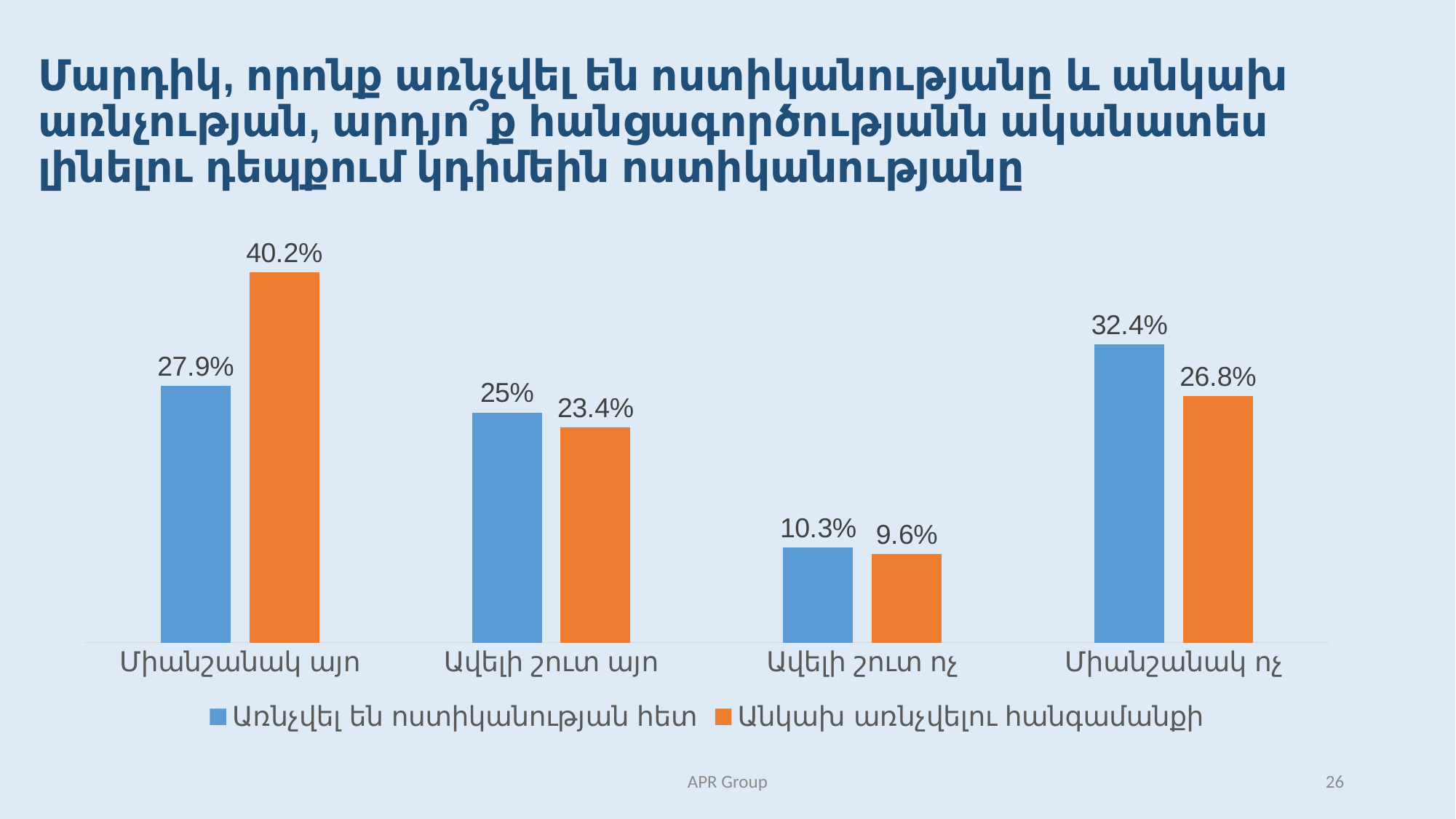
What kind of chart is shown on the slide? Bar chart How many categories are shown on the x axis? 4 For "Միանշանակ ոչ", which series has the larger value? Առնչվել են ոստիկանության հետ Which category has the highest value in the "Անկախ առնչվելու հանգամանքի" series? Միանշանակ այո What colour are the bars for the "Անկախ առնչվելու հանգամանքի" series? Orange What is the value for "Ավելի շուտ ոչ" in the "Անկախ առնչվելու հանգամանքի" series? 9.6% What is the value for "Միանշանակ այո" in the "Անկախ առնչվելու հանգամանքի" series? 40.2% What is the value for "Միանշանակ այո" in the "Առնչվել են ոստիկանության հետ" series? 27.9% What is the difference between the two series for "Միանշանակ այո"? 12.3% How many series does the legend list? 2 What is the value for "Միանշանակ ոչ" in the "Առնչվել են ոստիկանության հետ" series? 32.4% Which category has the lowest value in the "Առնչվել են ոստիկանության հետ" series? Ավելի շուտ ոչ